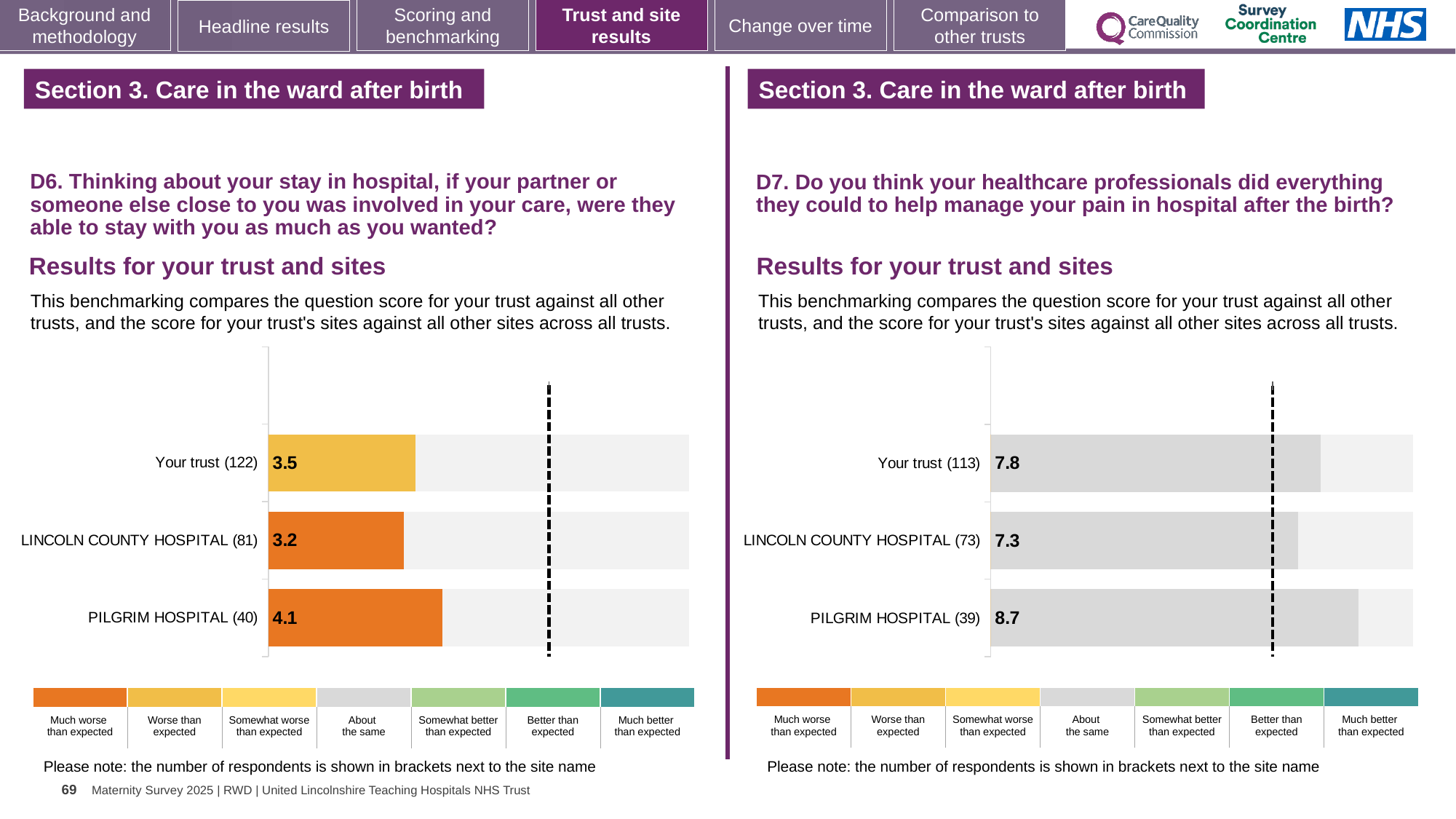
In the D6 chart on the left, what is the difference between the scores for PILGRIM HOSPITAL and LINCOLN COUNTY HOSPITAL? 0.9 In the D6 chart on the left, which site or trust has the highest score? PILGRIM HOSPITAL In the D7 chart on the right, is the score for Your trust or LINCOLN COUNTY HOSPITAL larger? Your trust In the D6 chart on the left, how many bars are plotted? 3 In the D7 chart on the right, what is the difference between the scores for PILGRIM HOSPITAL and Your trust? 0.9 In the D7 chart on the right, which site or trust has the lowest score? LINCOLN COUNTY HOSPITAL In the D6 chart on the left, how many respondents are shown in brackets for PILGRIM HOSPITAL? 40 In the D7 chart on the right, what is the score for Your trust? 7.8 In the D6 chart on the left, what is the score for Your trust? 3.5 What type of chart is the D6 chart on the left? Bar chart In the D6 chart on the left, what is the score for LINCOLN COUNTY HOSPITAL? 3.2 In the D7 chart on the right, what is the score for PILGRIM HOSPITAL? 8.7